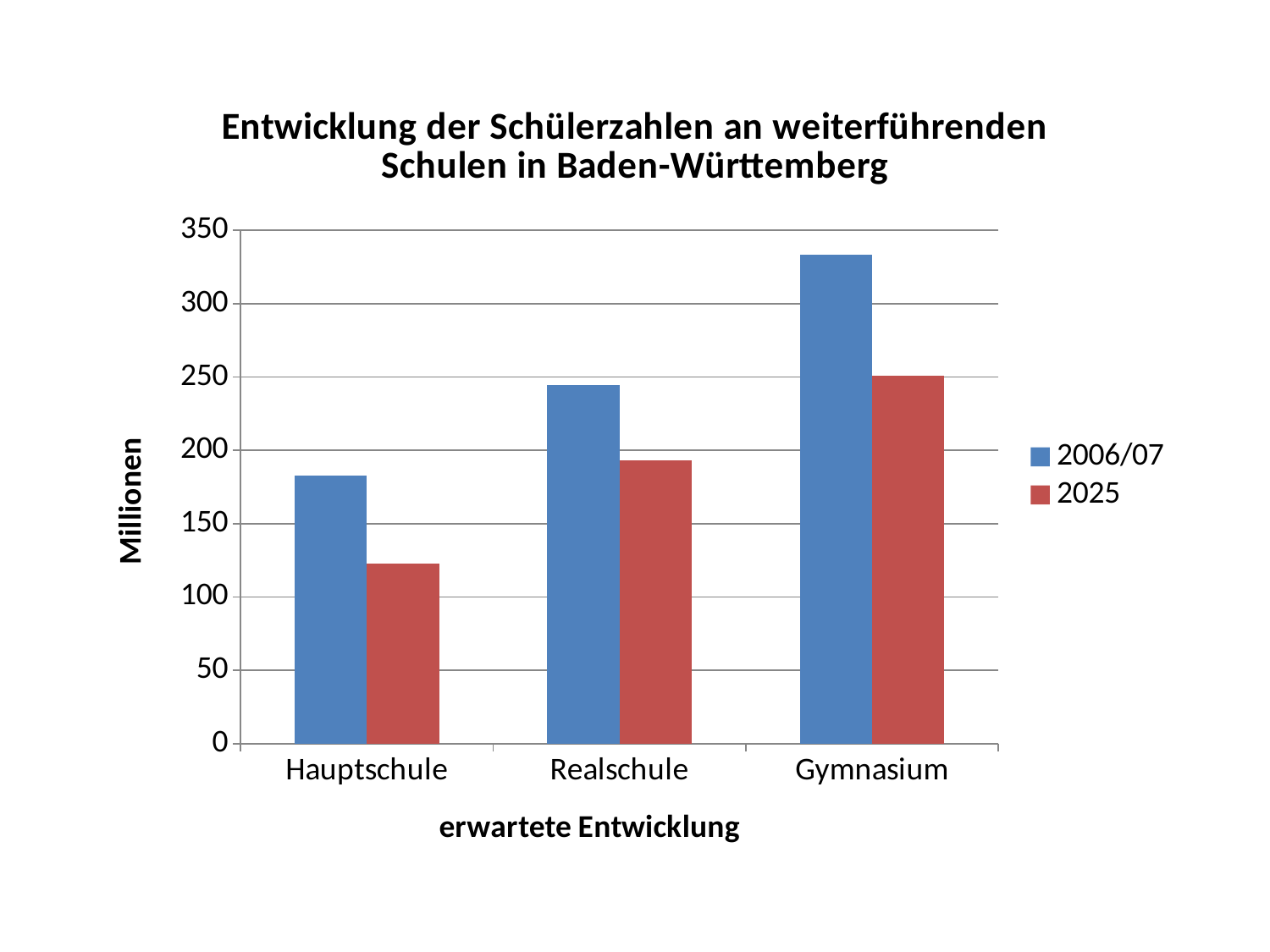
Is the 2006/07 value for Gymnasium greater or less than 300? greater Is the 2025 value for Hauptschule greater or less than 150? less How many series does the legend list? 2 Is the 2006/07 value for Hauptschule greater or less than 150? greater Which school type has the highest value for 2006/07? Gymnasium Which school type has the lowest value for 2025? Hauptschule What is the label of the x axis? erwartete Entwicklung For Realschule, which is larger: the 2006/07 value or the 2025 value? 2006/07 How many school types are shown on the x axis? 3 What kind of chart is shown on the slide? bar chart What is the label of the y axis? Millionen